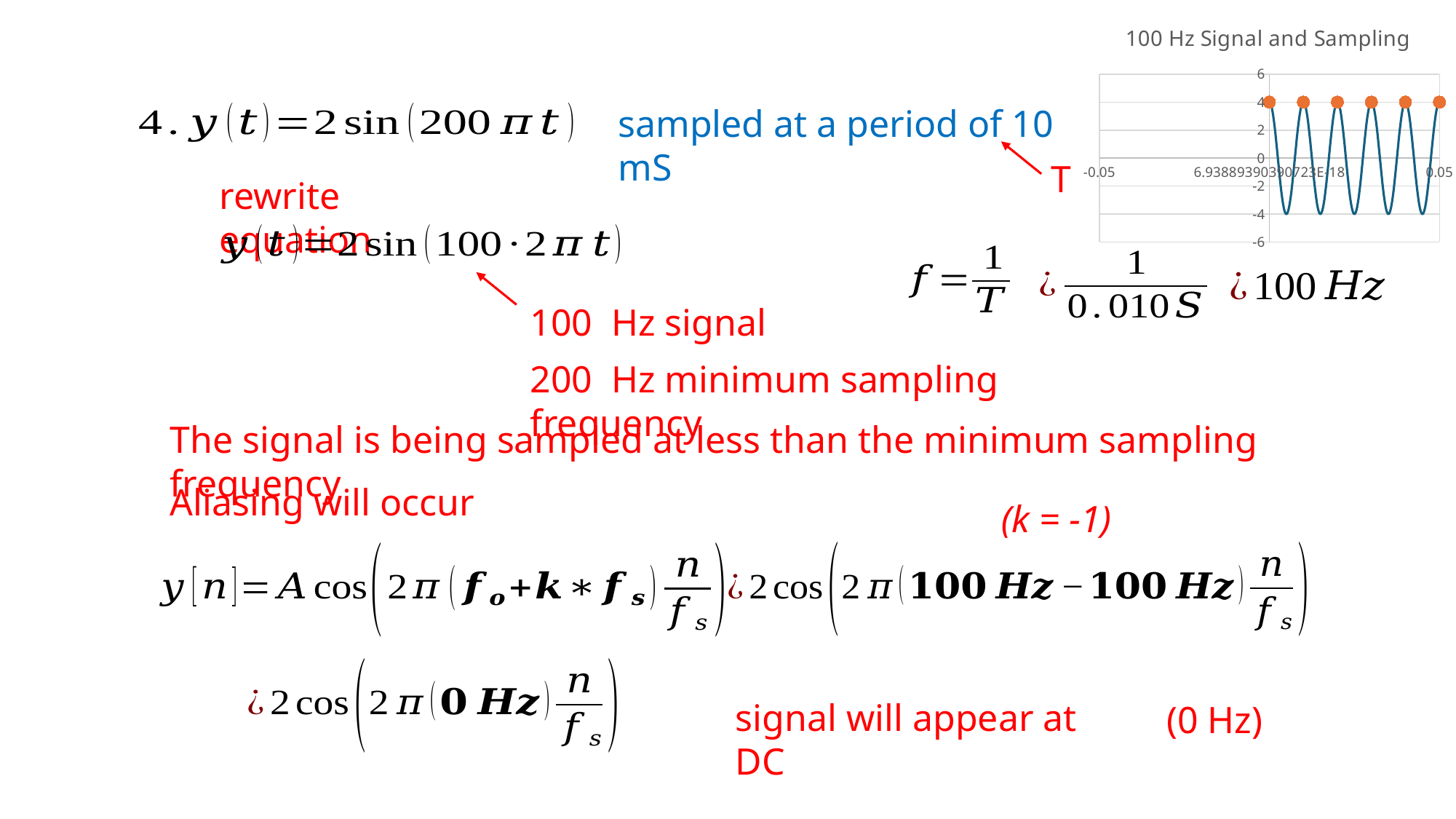
What is the title of the chart on the slide? 100 Hz Signal and Sampling What colour are the sample point markers on the chart? orange How many orange sample points are plotted on the chart? 6 Are the orange sample points on the chart plotted at a value greater or less than 6? less What kind of chart is shown on the slide? line chart Are the troughs of the waveform on the chart greater or less than -2? less What is the lowest tick value shown on the chart's vertical axis? -6 What is the leftmost tick value shown on the chart's horizontal axis? -0.05 What is the rightmost tick value shown on the chart's horizontal axis? 0.05 What is the highest tick value shown on the chart's vertical axis? 6 Are the orange sample points on the chart plotted at a value greater or less than 2? greater